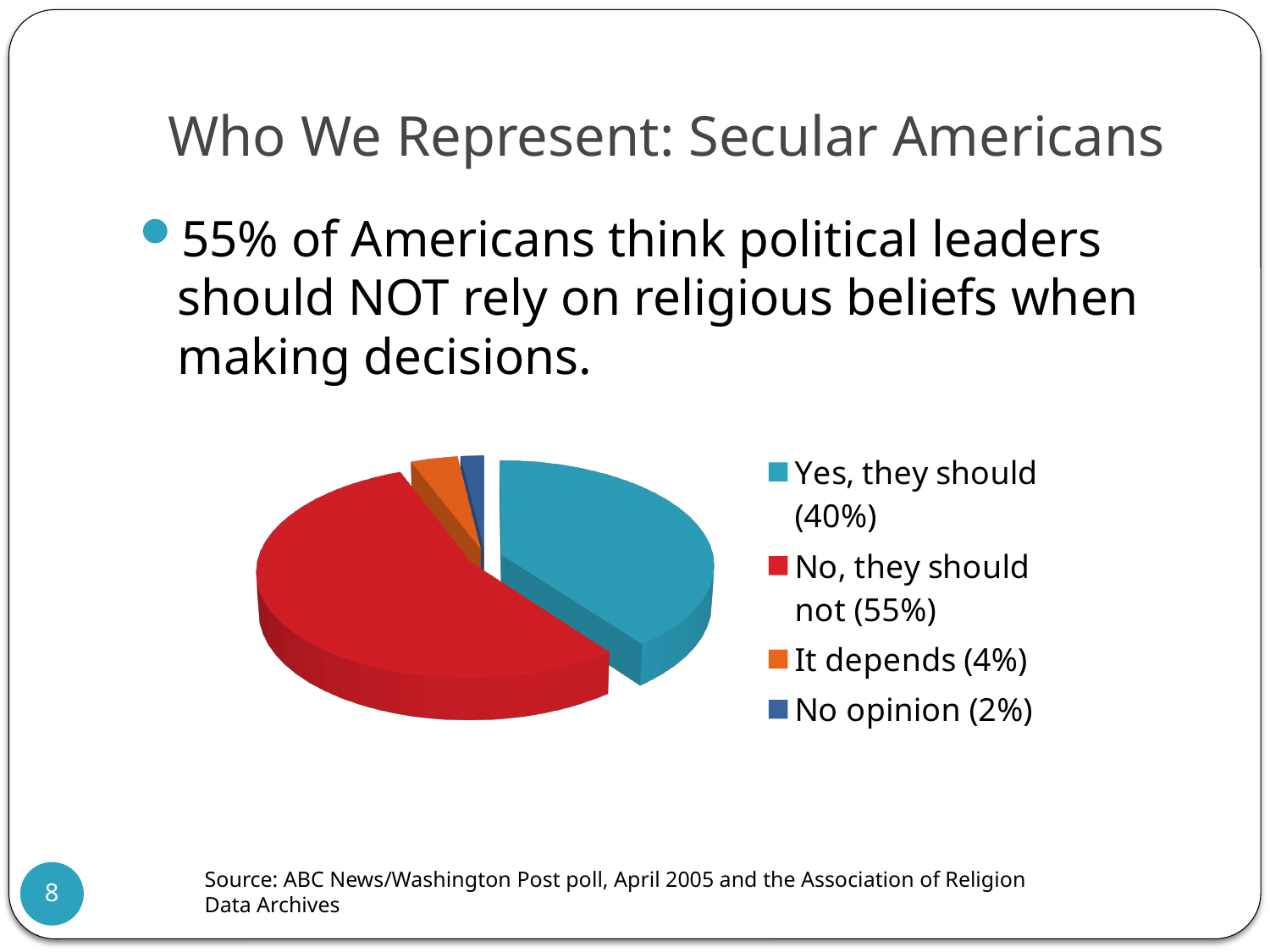
What share of the pie is 'It depends'? 4% What share of the pie is 'No, they should not'? 55% What colour is the 'No, they should not' slice? red How many slices does the pie chart have? 4 Which category has the largest slice of the pie? No, they should not What share of the pie is 'Yes, they should'? 40% Which is larger, the 'It depends' slice or the 'No opinion' slice? It depends How many entries does the legend list? 4 What kind of chart is shown on the slide? pie chart Which category has the smallest slice of the pie? No opinion What is the difference in percentage points between 'No, they should not' and 'Yes, they should'? 15